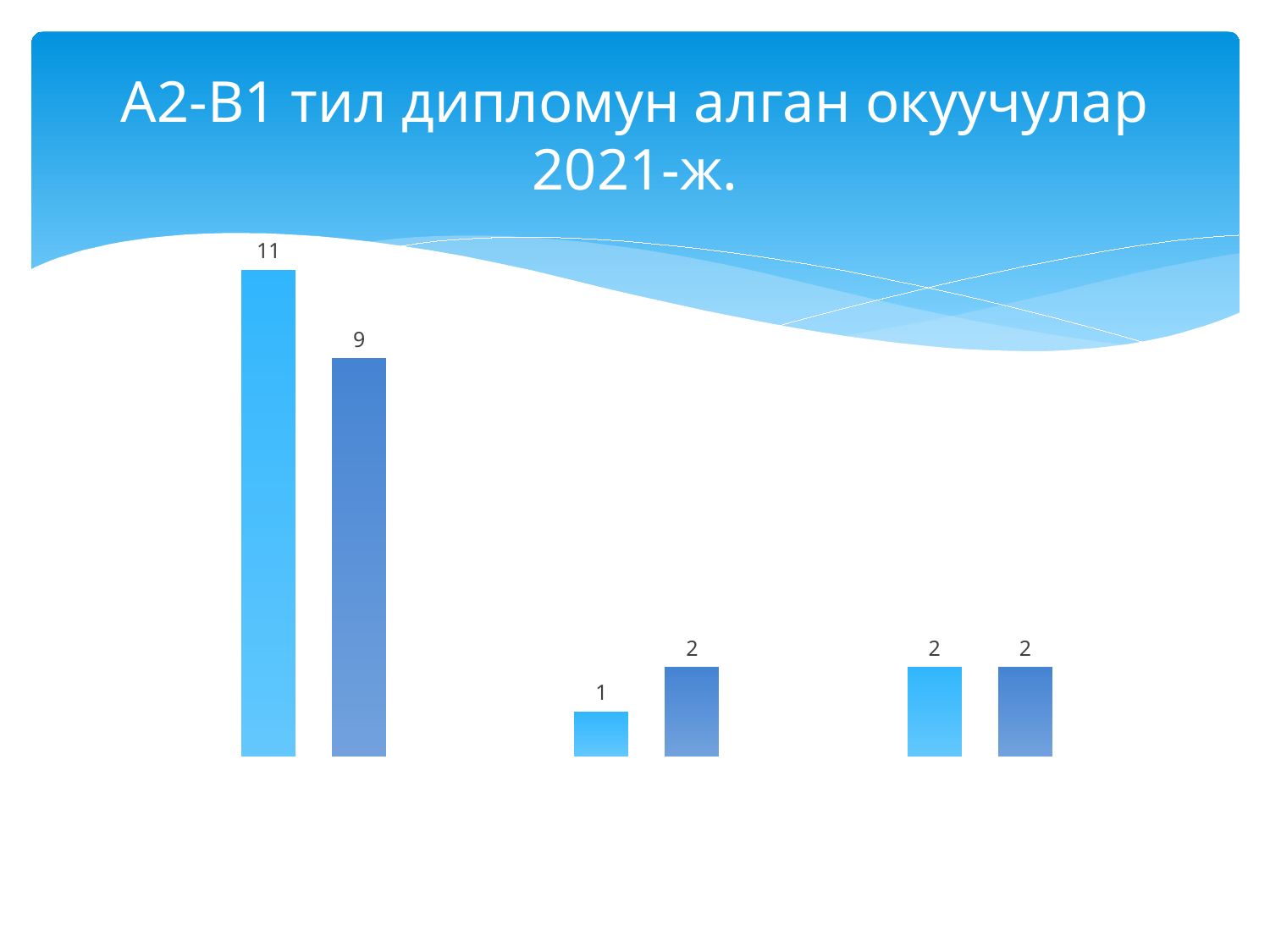
How many bars are plotted in the chart? 6 What is the value of the leftmost bar in the chart? 11 What is the value of the second bar from the left in the chart? 9 What is the lowest value shown in the chart? 1 What is the value of the dark blue bar in the middle group? 2 How many groups of bars does the chart show? 3 What is the highest value shown in the chart? 11 What is the difference between the two bars in the leftmost group? 2 What kind of chart is shown on the slide? bar chart What is the value of the light blue bar in the middle group? 1 What is the title of the chart on the slide? А2-В1 тил дипломун алган окуучулар 2021-ж. Which bar is taller in the leftmost group, the light blue bar or the dark blue bar? the light blue bar